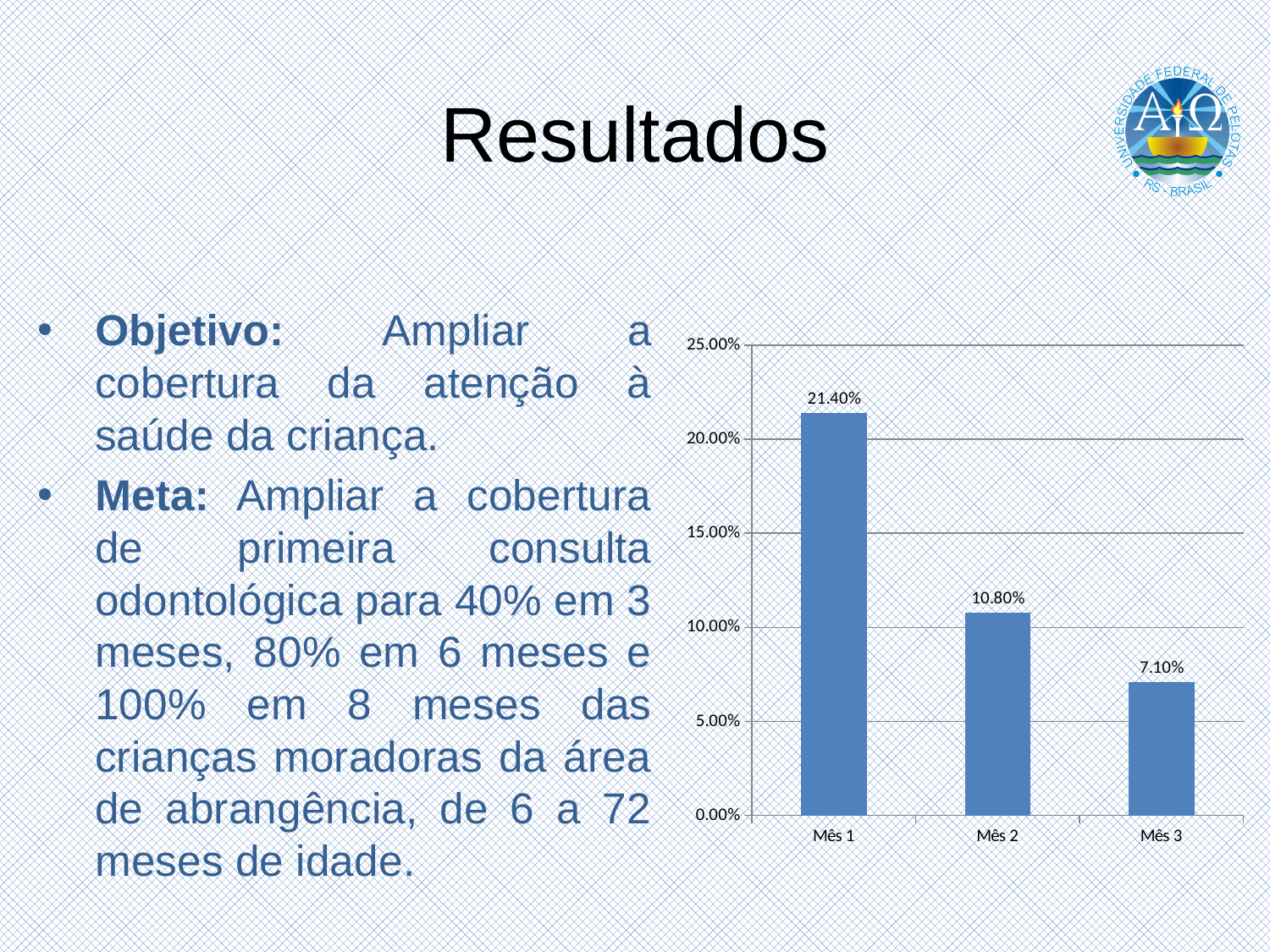
Is the value for Mês 1 greater or less than 20.00%? greater Which category has the lowest value? Mês 3 What is the value for Mês 1? 21.40% What is the difference between the values for Mês 1 and Mês 2? 10.60% Which is larger, the value for Mês 2 or the value for Mês 3? Mês 2 What is the value for Mês 3? 7.10% What is the value for Mês 2? 10.80% What is the difference between the values for Mês 2 and Mês 3? 3.70% Do the values rise or fall from Mês 1 to Mês 3? fall Which category has the highest value? Mês 1 What kind of chart is shown on the slide? bar chart How many categories are shown on the x axis? 3